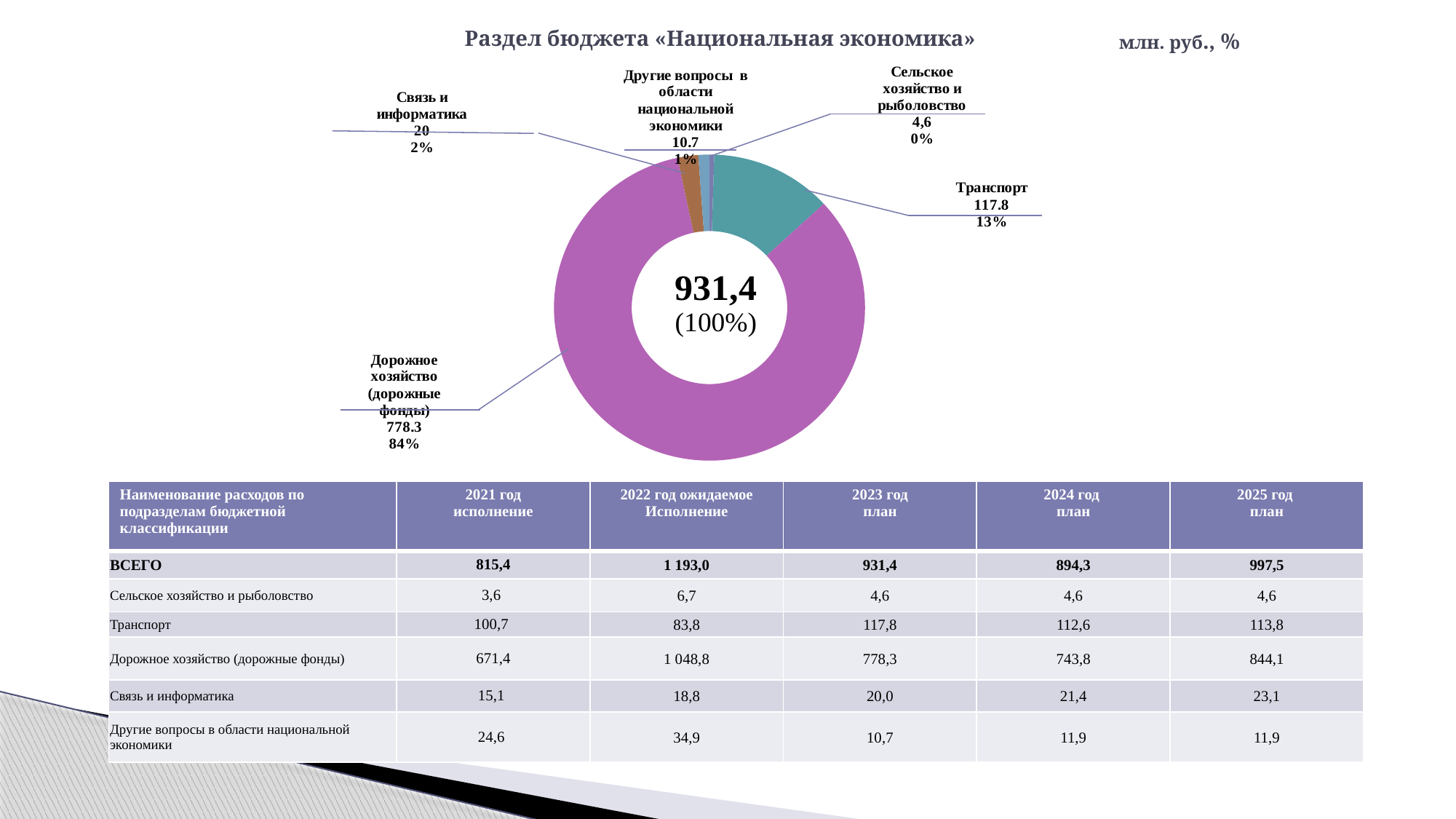
What is the value shown for Сельское хозяйство и рыболовство in the chart? 4,6 Which category has the largest slice in the chart? Дорожное хозяйство (дорожные фонды) Which category has the smallest slice in the chart? Сельское хозяйство и рыболовство What is the value shown for Транспорт in the chart? 117.8 What is the difference between the values for Транспорт and Связь и информатика in the chart? 97.8 What is the value shown for Связь и информатика in the chart? 20 What share of the chart does Транспорт represent? 13% What share of the chart does Дорожное хозяйство (дорожные фонды) represent? 84% What total value is shown in the centre of the chart? 931,4 How many categories are shown in the chart? 5 What is the value shown for Дорожное хозяйство (дорожные фонды) in the chart? 778.3 What type of chart is shown on the slide? Pie (donut) chart